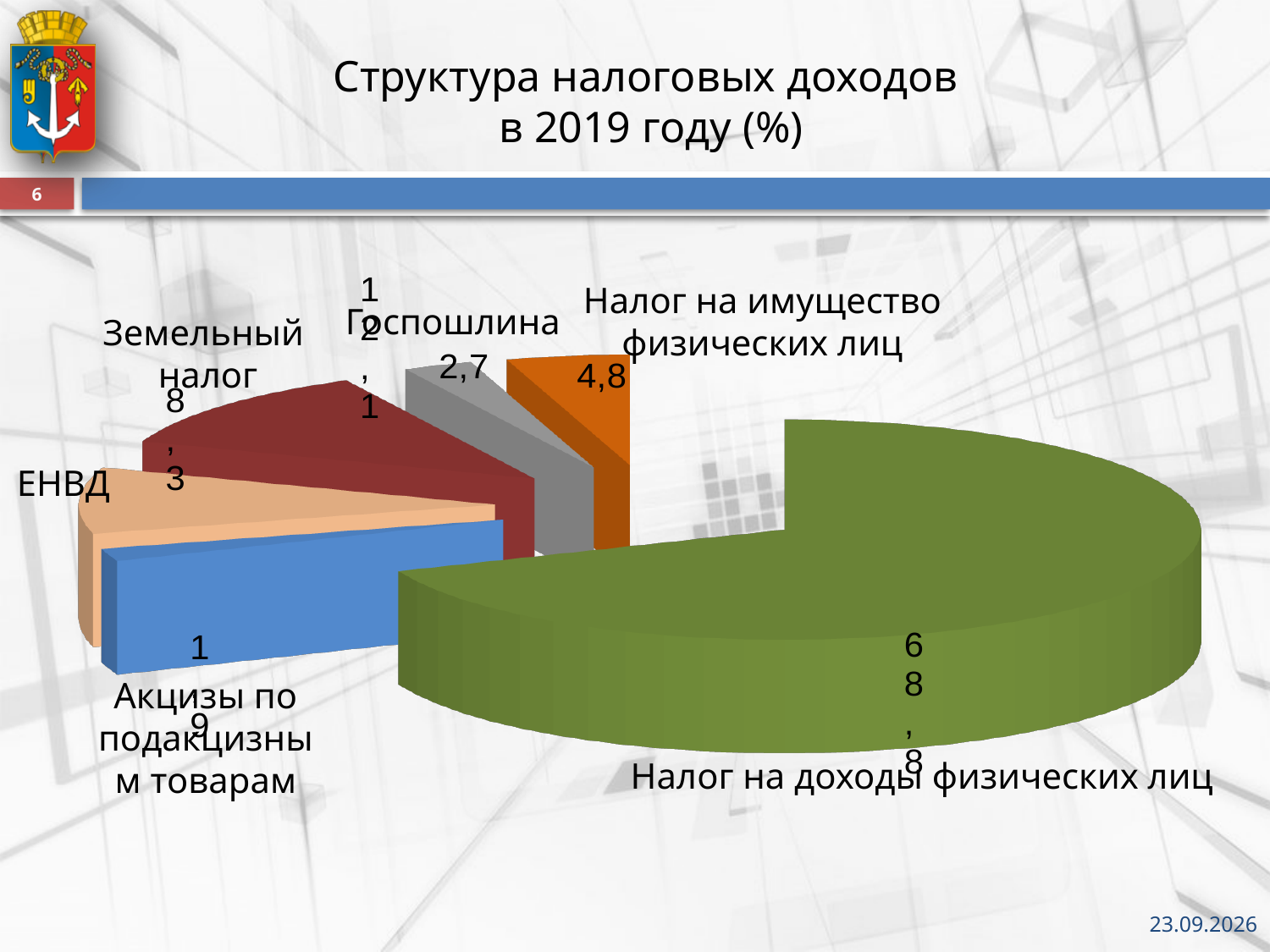
What is the value for Налог на имущество физических лиц? 4,8 What is the value for Земельный налог? 12,1 What kind of chart is shown on the slide? pie chart Which category has the smallest share of the pie? Акцизы по подакцизным товарам What is the value for ЕНВД? 8,3 Which is larger: the value for ЕНВД or the value for Налог на имущество физических лиц? ЕНВД Which category has the largest share of the pie? Налог на доходы физических лиц What is the value for Госпошлина? 2,7 What is the value for Налог на доходы физических лиц? 68,8 How many categories (slices) does the pie chart show? 6 What is the difference between the values for Налог на имущество физических лиц and Госпошлина? 2,1 What is the title of the chart on the slide? Структура налоговых доходов в 2019 году (%)